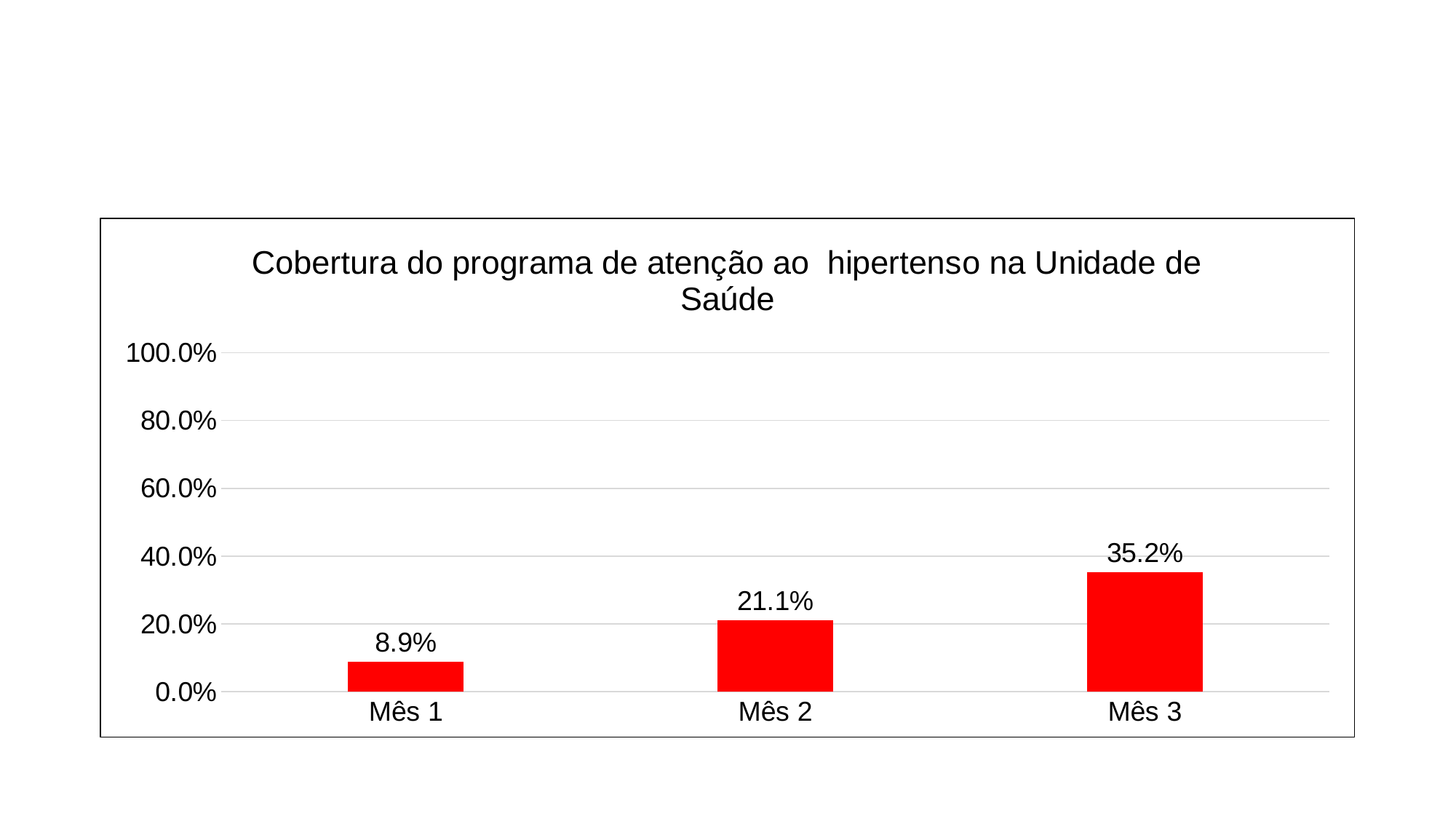
What is the value for Mês 3? 35.2% What is the value for Mês 1? 8.9% What kind of chart is this? bar chart Which is larger, the value for Mês 1 or the value for Mês 2? Mês 2 Is the value for Mês 3 greater or less than 40.0%? less How many months are shown on the x axis? 3 Do the values rise or fall from Mês 1 to Mês 3? rise What is the difference between the values for Mês 2 and Mês 1? 12.2% Which month has the lowest value? Mês 1 Which month has the highest value? Mês 3 What is the value for Mês 2? 21.1% What is the difference between the values for Mês 3 and Mês 2? 14.1%